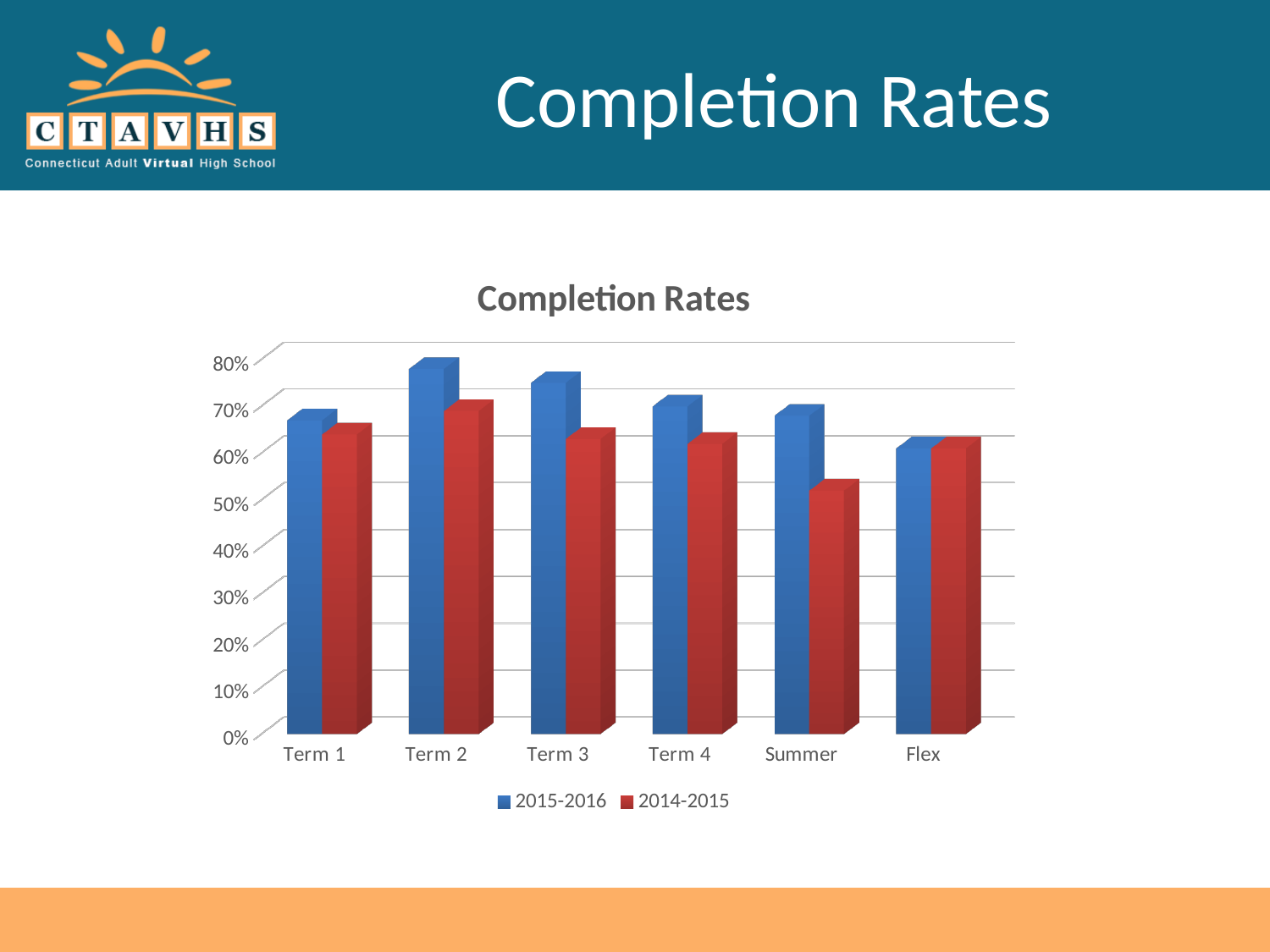
How many series does the legend list? 2 Which series is shown in blue? 2015-2016 Which category has the lowest value for the 2014-2015 series? Summer Is the 2014-2015 value for Summer greater or less than 60%? less Which category has the highest value for the 2015-2016 series? Term 2 Is the 2015-2016 value for Term 2 greater or less than 70%? greater What kind of chart is shown on the slide? Bar chart Which category has the highest value for the 2014-2015 series? Term 2 What is the title of the chart? Completion Rates How many categories are shown on the x axis? 6 For Term 2, which series has the larger value, 2015-2016 or 2014-2015? 2015-2016 For Summer, which series has the larger value, 2015-2016 or 2014-2015? 2015-2016